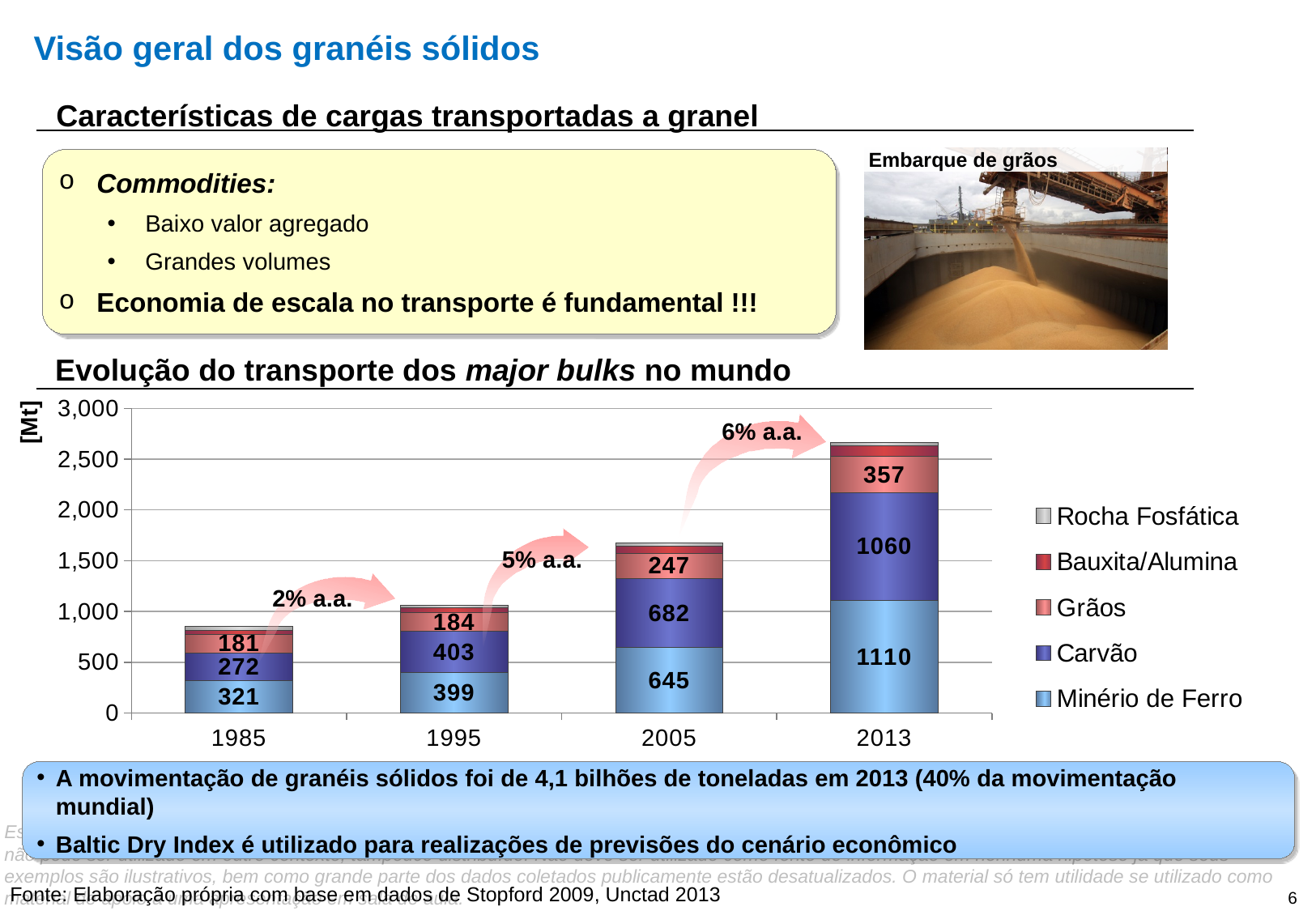
What is the value for Minério de Ferro in 2013? 1110 What is the difference between the Carvão value in 2013 and in 2005? 378 What annual growth rate is annotated between 2005 and 2013? 6% a.a. What is the value for Grãos in 2005? 247 What is the value for Carvão in 1995? 403 How many years are shown on the x axis? 4 What kind of chart is shown? stacked bar chart Is the total height of the 2013 stacked bar greater or less than 2,500? greater In which year is the Grãos value lowest? 1985 How many series does the legend list? 5 In which year is the Minério de Ferro value highest? 2013 In 1995, which is larger: Carvão or Minério de Ferro? Carvão